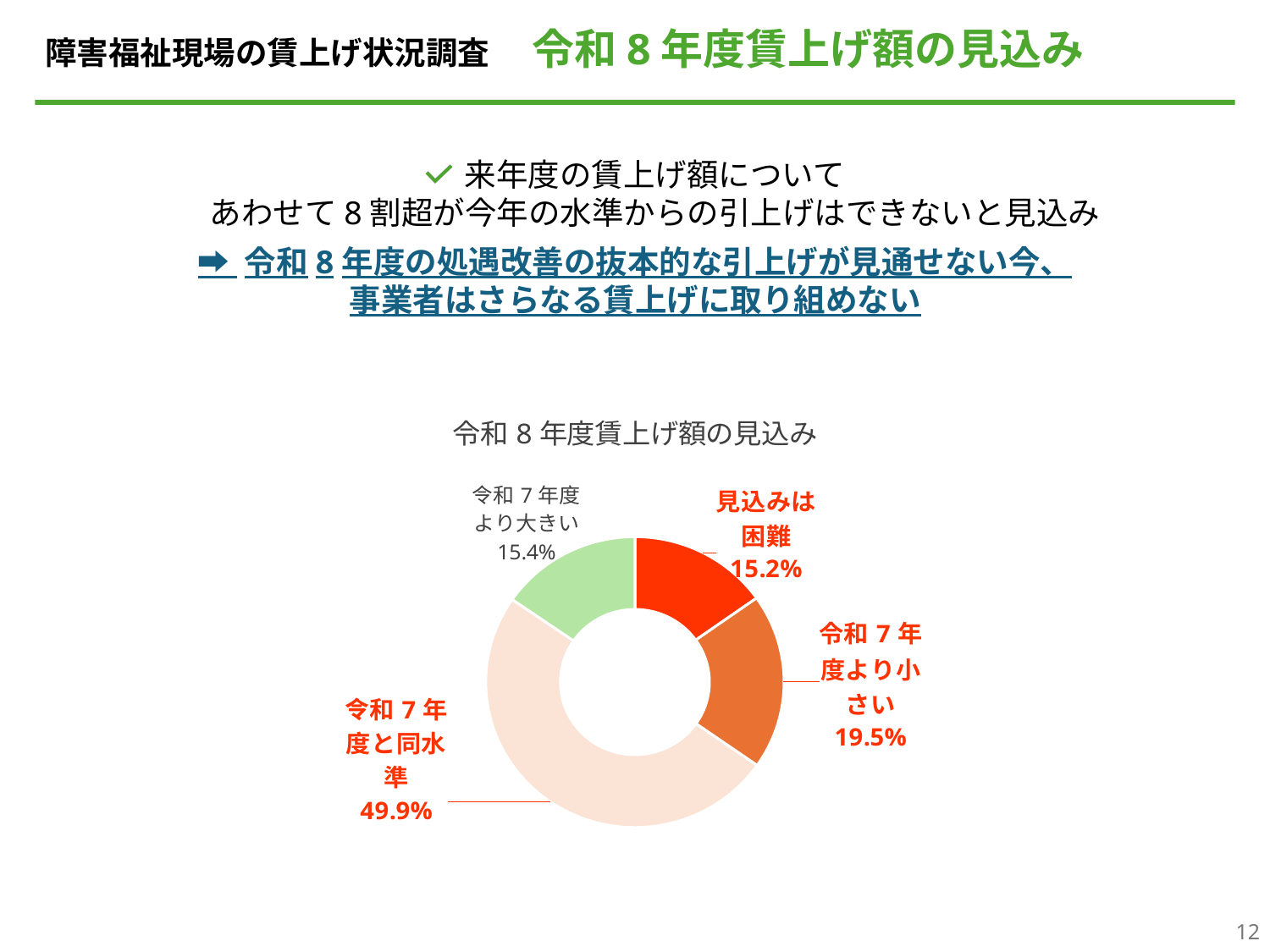
Which is larger, 令和7年度より小さい or 令和7年度より大きい? 令和7年度より小さい What is the value for 令和7年度と同水準? 49.9% What colour is the 令和7年度より大きい slice? Light green What is the title of the chart? 令和8年度賃上げ額の見込み What is the difference between 令和7年度と同水準 and 令和7年度より小さい? 30.4% How many categories does the chart show? 4 Which category has the largest share? 令和7年度と同水準 What is the value for 令和7年度より大きい? 15.4% What kind of chart is shown on the slide? Pie chart (donut) What is the value for 令和7年度より小さい? 19.5% What is the value for 見込みは困難? 15.2% Which category has the smallest share? 見込みは困難